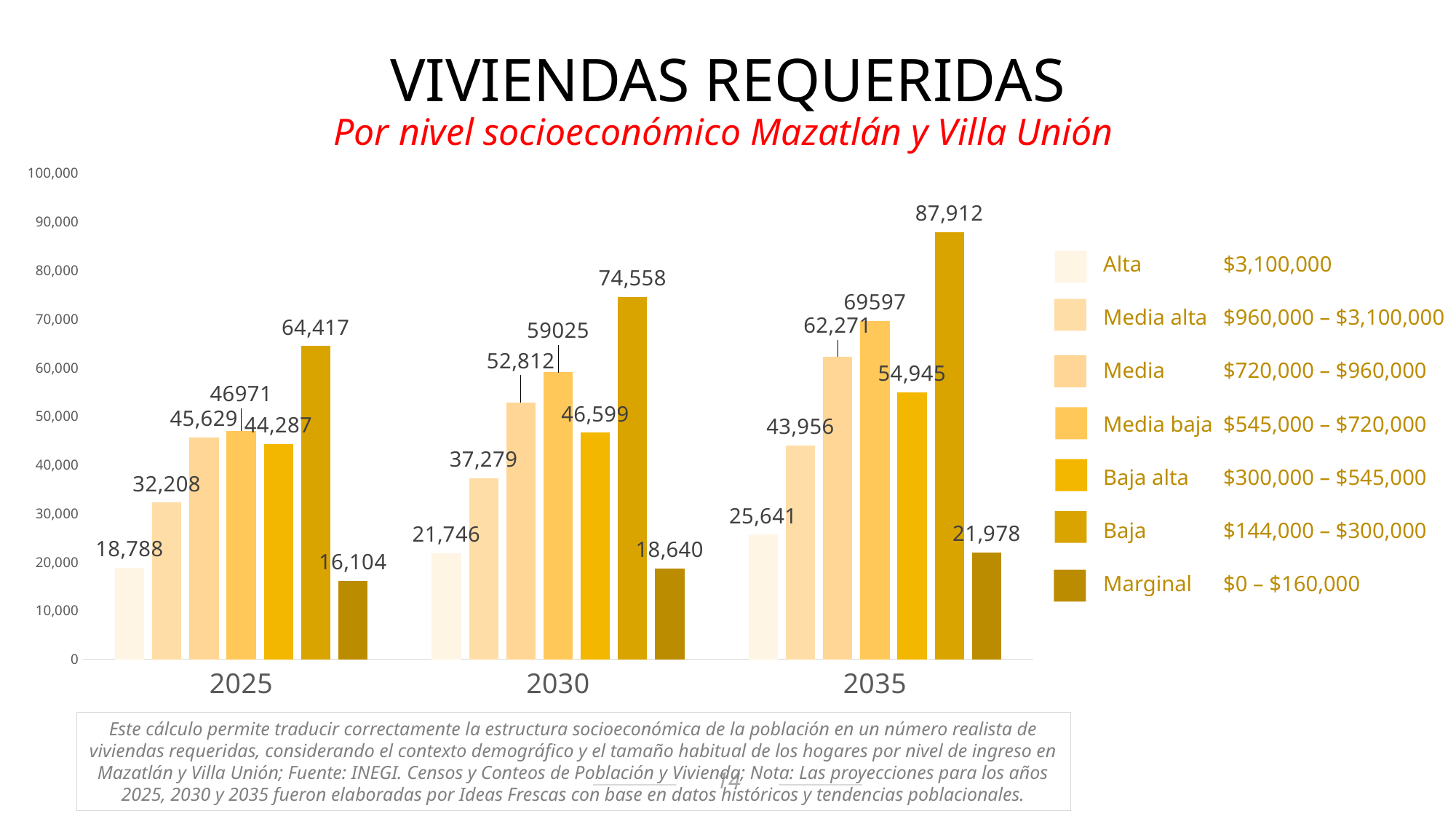
What is the value for Media baja in 2030? 59025 How many year categories are shown on the x axis? 3 What price range does the legend give for the Baja alta level? $300,000 – $545,000 What is the value for Baja in 2035? 87,912 Does the value for Baja rise or fall from 2025 to 2035? rise What is the difference between the Baja values for 2035 and 2025? 23,495 What is the value for Alta in 2025? 18,788 How many series does the legend list? 7 What type of chart is shown on the slide? bar chart Which series has the lowest value in 2025? Marginal Which is larger in 2030: Media or Baja alta? Media Which series has the highest value in 2030? Baja